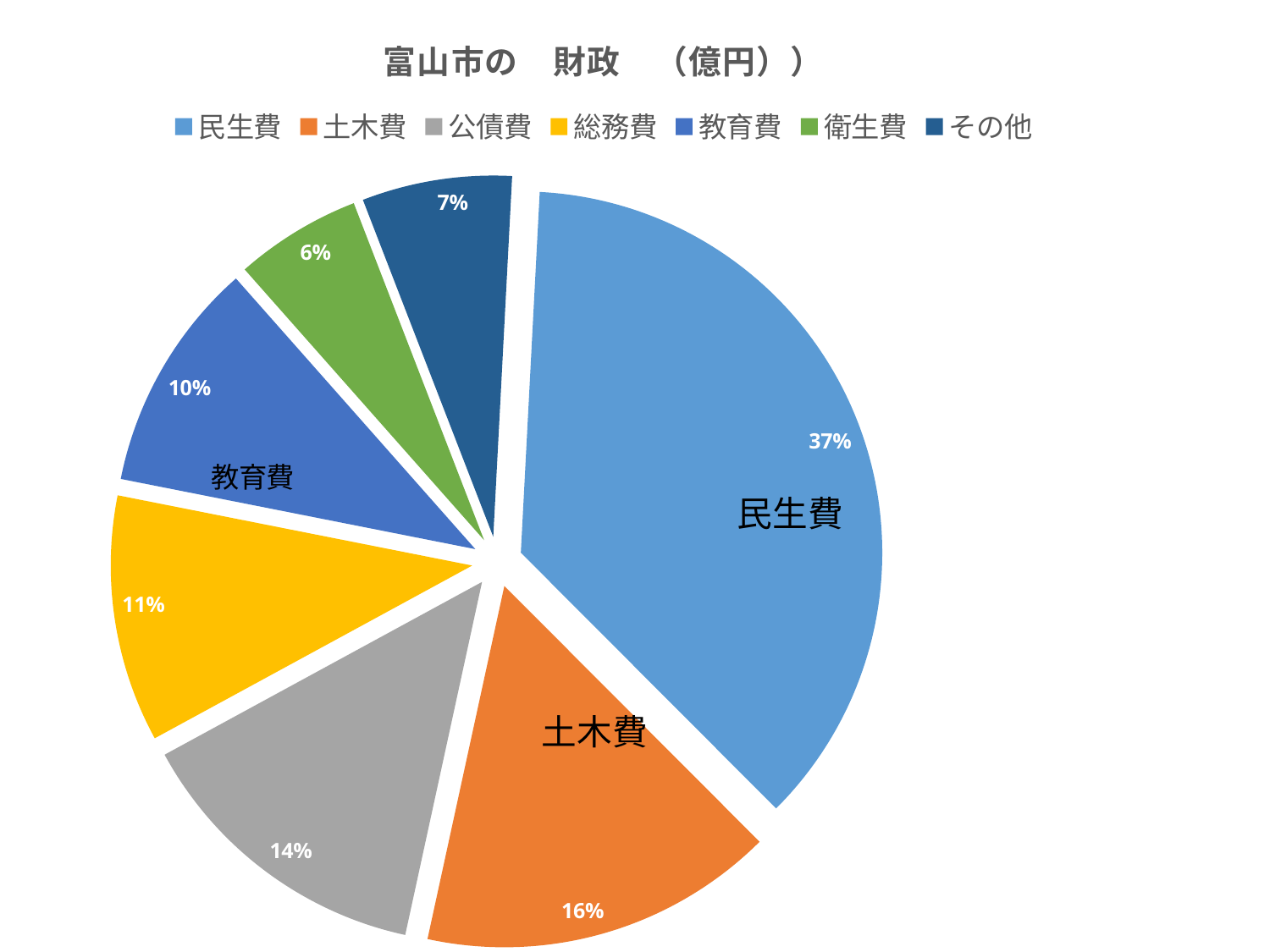
Which category has the smallest slice of the pie? 衛生費 What share of the pie does 公債費 take? 14% Which category has the largest slice of the pie? 民生費 What share of the pie does 民生費 take? 37% What is the title of the chart? 富山市の 財政 （億円）） What is the difference in percentage points between 民生費 and 土木費? 21 What share of the pie does 教育費 take? 10% Which slice is larger, 総務費 or その他? 総務費 What kind of chart is shown on the slide? pie chart How many categories does the pie chart show? 7